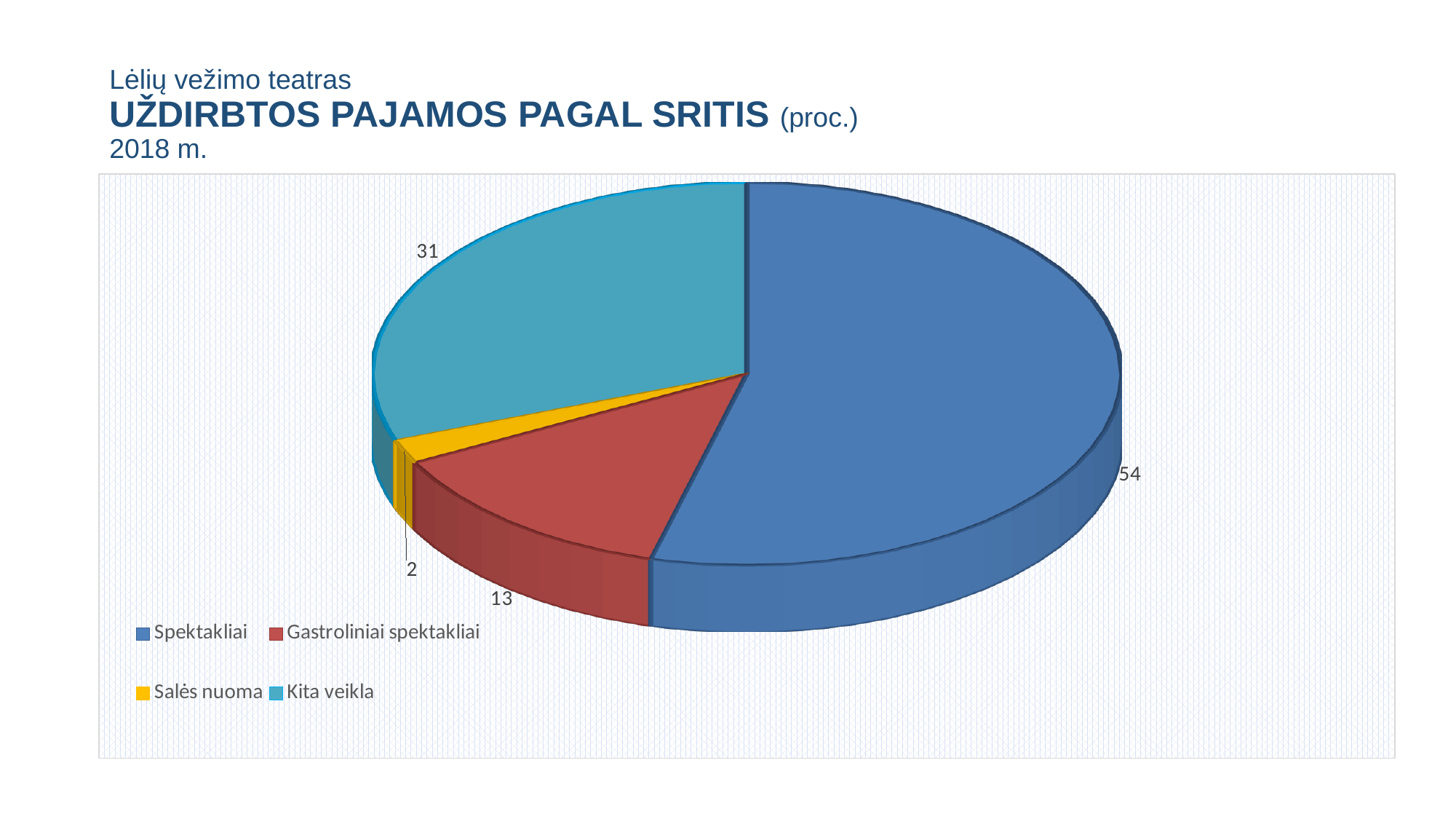
What is the value for Spektakliai? 54 What is the difference between the values for Spektakliai and Kita veikla? 23 Which colour represents Salės nuoma in the legend? Yellow Which is larger, Gastroliniai spektakliai or Kita veikla? Kita veikla What is the value for Kita veikla? 31 How many categories does the pie chart show? 4 What kind of chart is shown on the slide? Pie chart What is the value for Salės nuoma? 2 What share of the pie does Kita veikla represent? 31 Which category has the smallest slice of the pie? Salės nuoma What is the value for Gastroliniai spektakliai? 13 Which category has the largest slice of the pie? Spektakliai